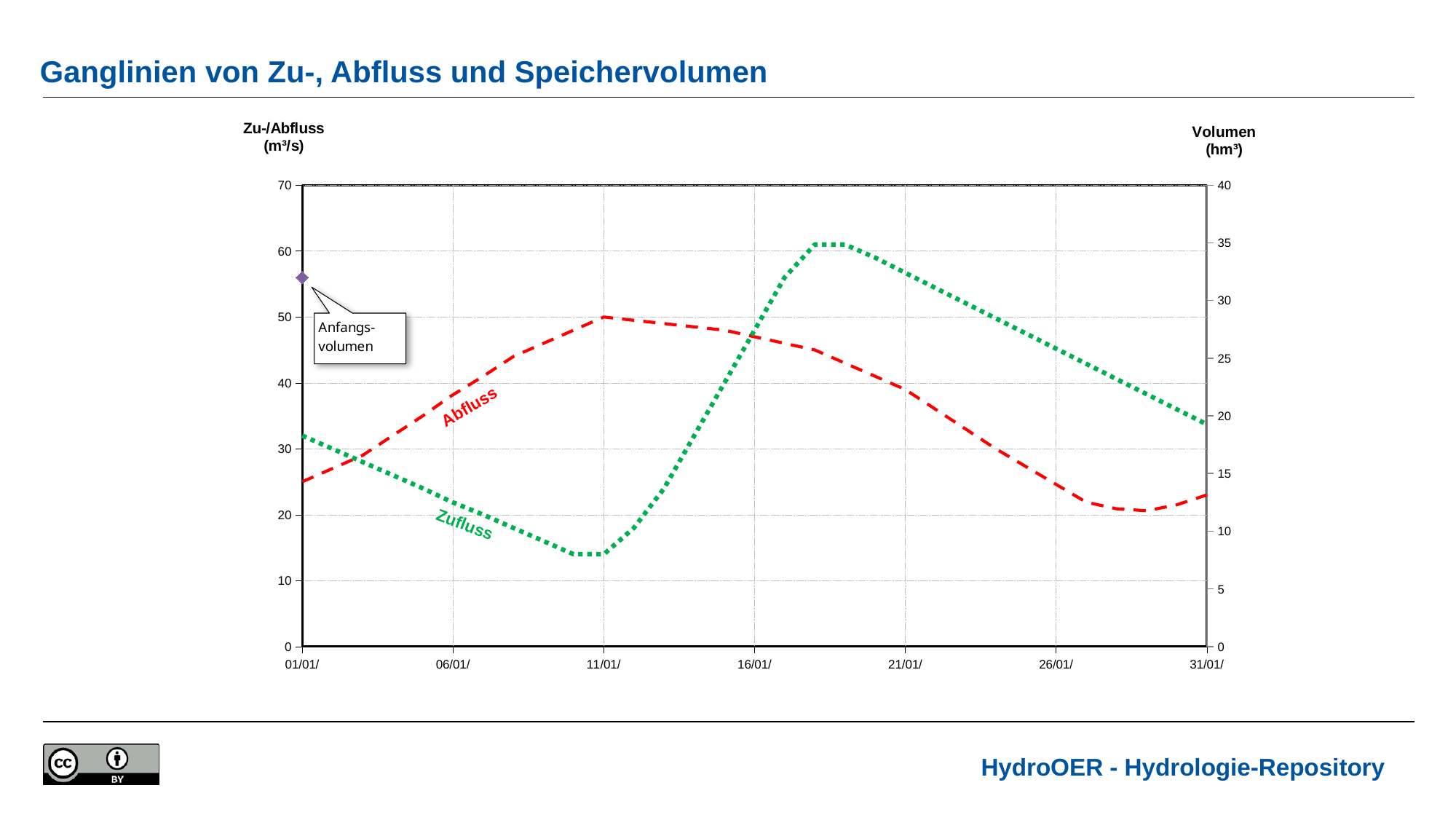
What kind of chart is shown on the slide? line chart What is the unit shown on the right-hand (Volumen) axis? hm³ Is the peak Zufluss value greater or less than 50 m³/s? greater Does the Zufluss line rise or fall between 01/01 and 11/01? fall How many dates are labelled on the x axis? 7 What is the title of the slide's chart? Ganglinien von Zu-, Abfluss und Speichervolumen On 21/01, which is larger, Zufluss or Abfluss? Zufluss Is the Zufluss value on 11/01 greater or less than 20 m³/s? less On 11/01, which is larger, Zufluss or Abfluss? Abfluss Is the Zufluss value on 01/01 greater or less than 30 m³/s? greater How many lines (series) are plotted in the chart? 2